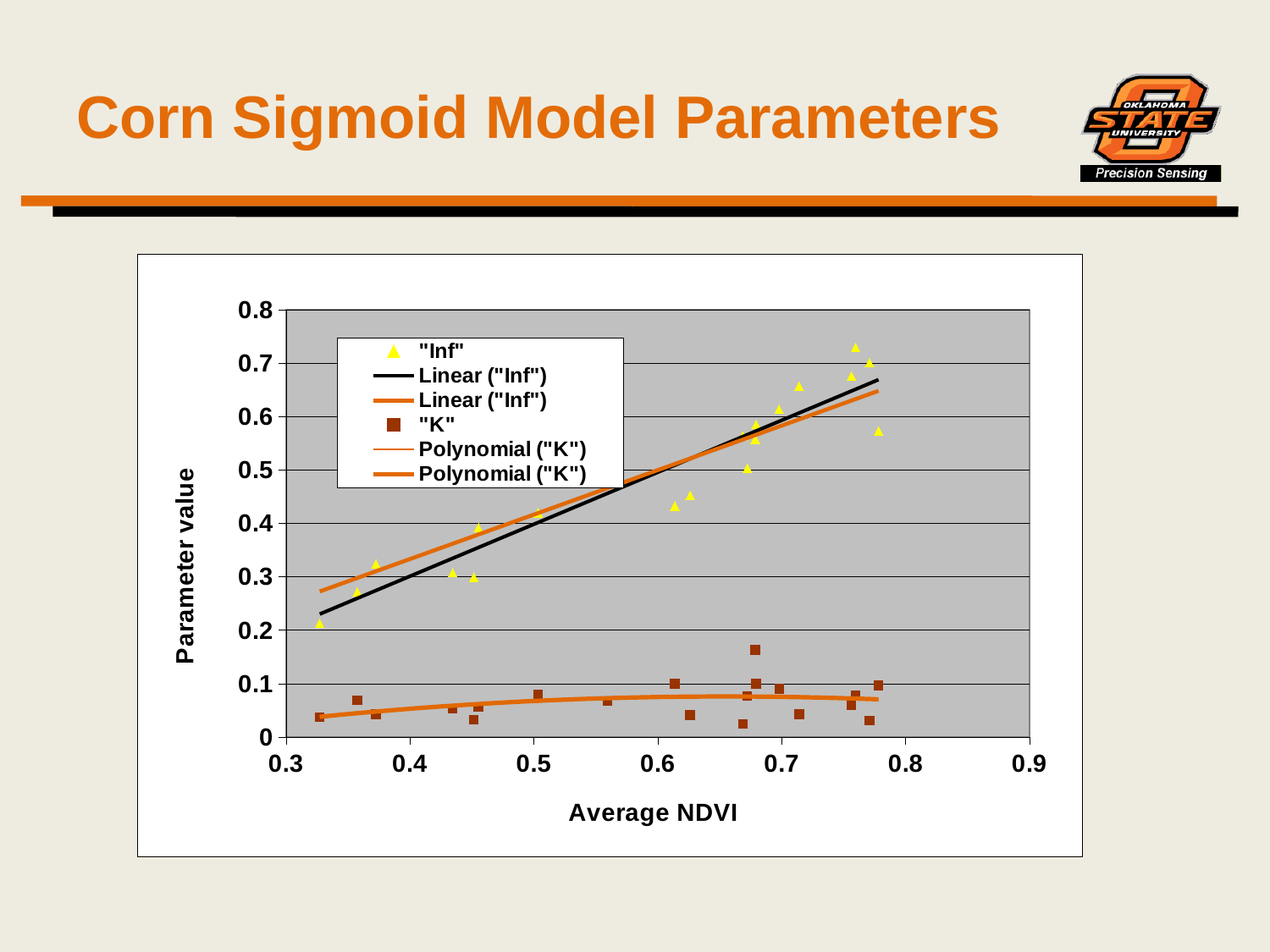
Do the "Inf" values rise or fall as Average NDVI increases? Rise Is the highest "Inf" value greater or less than 0.7? greater Which series has the lowest plotted value on the chart, "Inf" or "K"? "K" Is the highest "K" value greater or less than 0.2? less At an Average NDVI of about 0.7, is the "Inf" value greater or less than 0.5? greater What is the title of the x axis? Average NDVI Which series has the higher parameter values overall, "Inf" or "K"? "Inf" How many entries does the chart legend list? 6 What is the title of the y axis? Parameter value What kind of chart is shown on the slide? Scatter chart